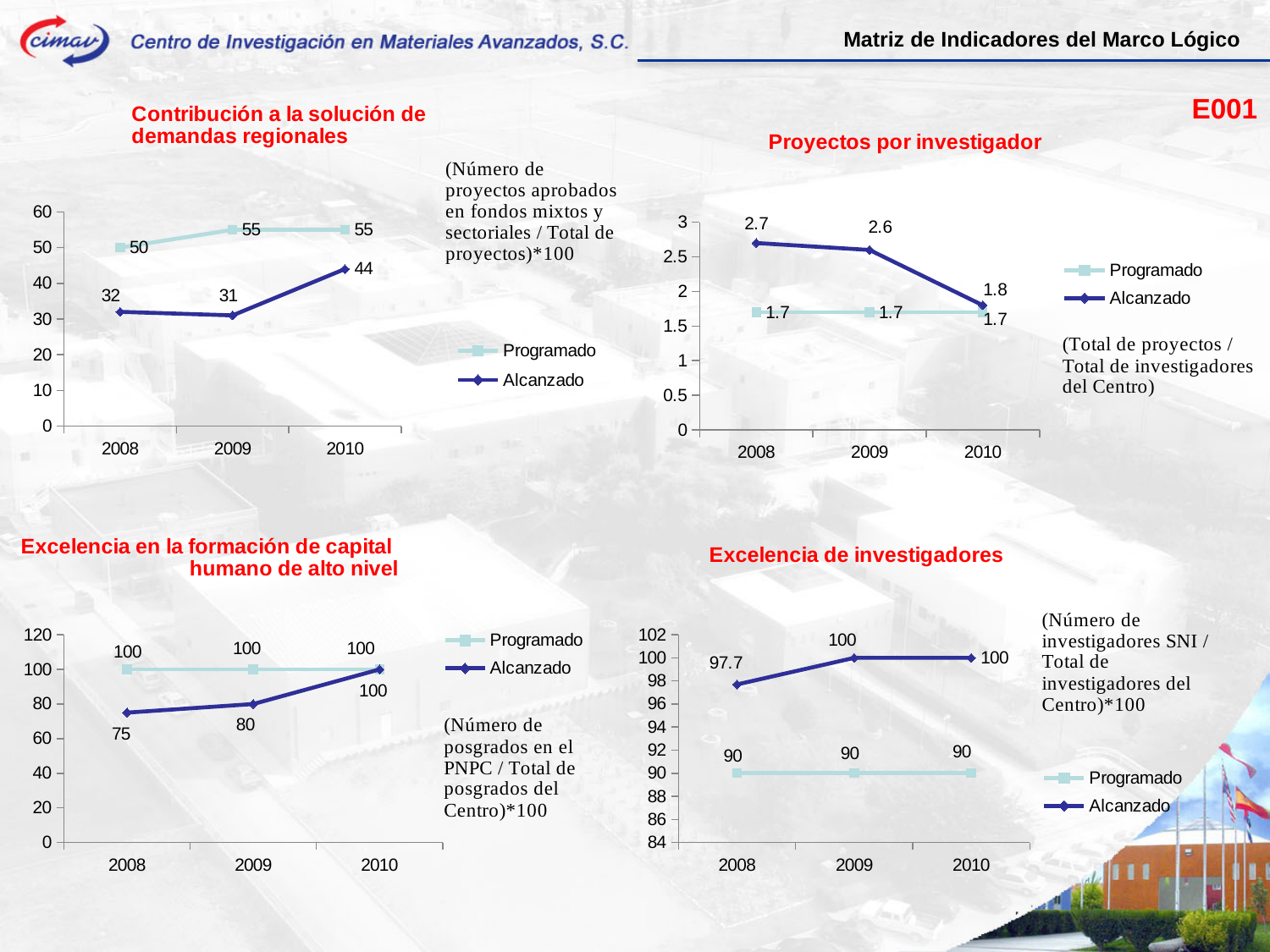
In the 'Proyectos por investigador' chart, does the Alcanzado series rise or fall from 2008 to 2010? fall In the 'Excelencia de investigadores' chart, what is the Alcanzado value for 2008? 97.7 In the 'Contribución a la solución de demandas regionales' chart, what is the Alcanzado value for 2010? 44 In the 'Contribución a la solución de demandas regionales' chart, what is the Programado value for 2008? 50 In the 'Proyectos por investigador' chart, what is the Alcanzado value for 2008? 2.7 What type of chart is the 'Proyectos por investigador' chart? line chart In the 'Excelencia en la formación de capital humano de alto nivel' chart, which is larger in 2009, Programado or Alcanzado? Programado How many series does the legend of the 'Excelencia de investigadores' chart list? 2 In the 'Contribución a la solución de demandas regionales' chart, what is the difference between the Programado and Alcanzado values in 2009? 24 In the 'Proyectos por investigador' chart, in which year is the Alcanzado value lowest? 2010 In the 'Excelencia en la formación de capital humano de alto nivel' chart, what is the Alcanzado value for 2008? 75 In the 'Excelencia de investigadores' chart, what is the difference between the Alcanzado and Programado values in 2010? 10